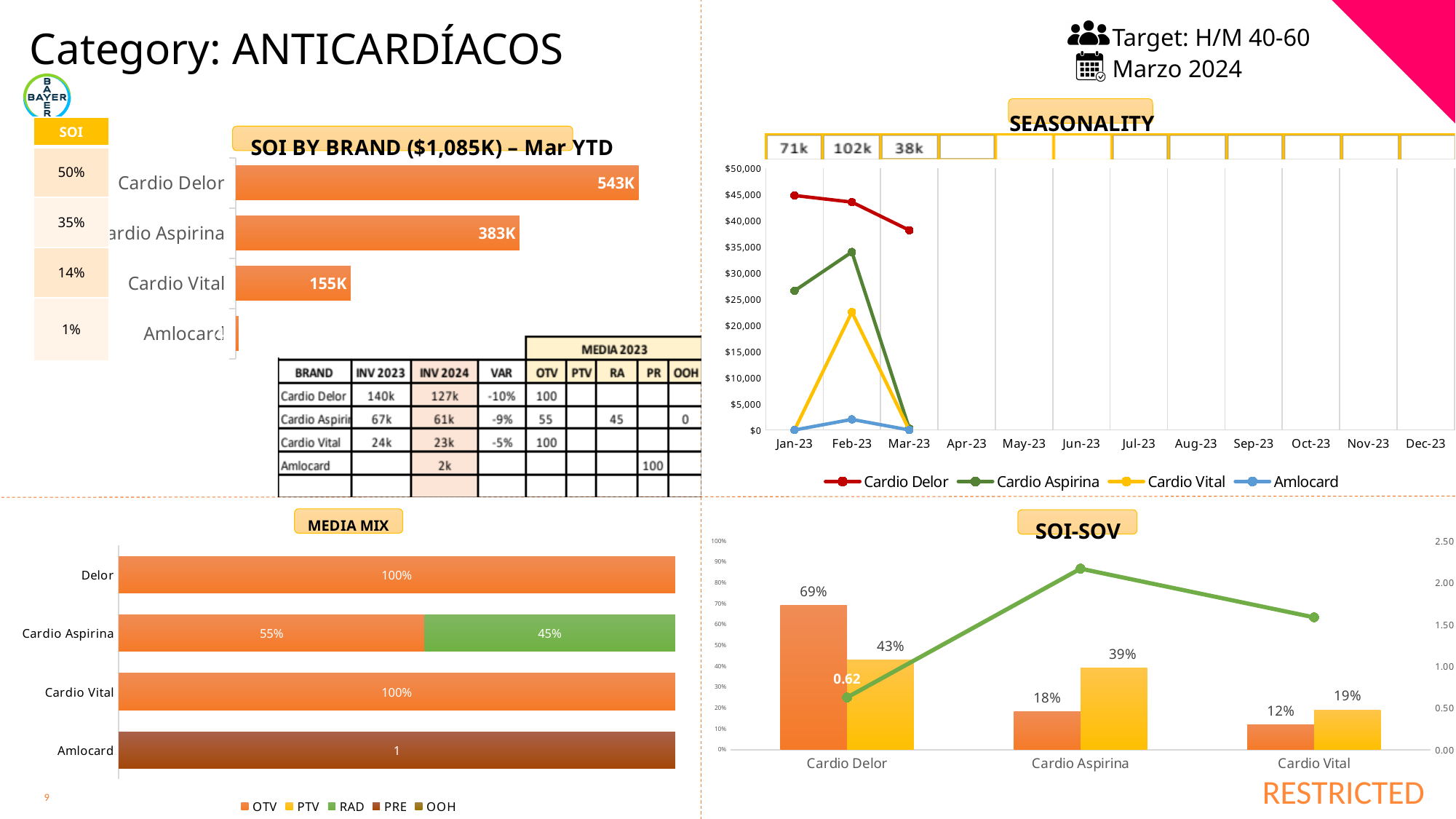
In the SOI BY BRAND chart, how many brands are shown? 4 In the MEDIA MIX chart, what share of Cardio Aspirina's media mix is RAD? 45% In the SOI BY BRAND chart, which brand has the lowest value? Amlocard In the MEDIA MIX chart, how many series does the legend list? 5 In the SEASONALITY chart, how many series does the legend list? 4 In the SOI-SOV chart, what is the value of the orange bar for Cardio Delor? 69% In the SOI BY BRAND chart, what is the value for Cardio Aspirina? 383K In the SOI BY BRAND chart, what is the value for Cardio Delor? 543K In the SOI-SOV chart, what is the value of the yellow bar for Cardio Aspirina? 39% In the SOI BY BRAND chart, what is the difference between Cardio Delor and Cardio Vital? 388K In the SEASONALITY chart, is the value for Cardio Delor in Jan-23 greater or less than $40,000? greater In the SEASONALITY chart, does the Cardio Delor line rise or fall from Jan-23 to Mar-23? fall